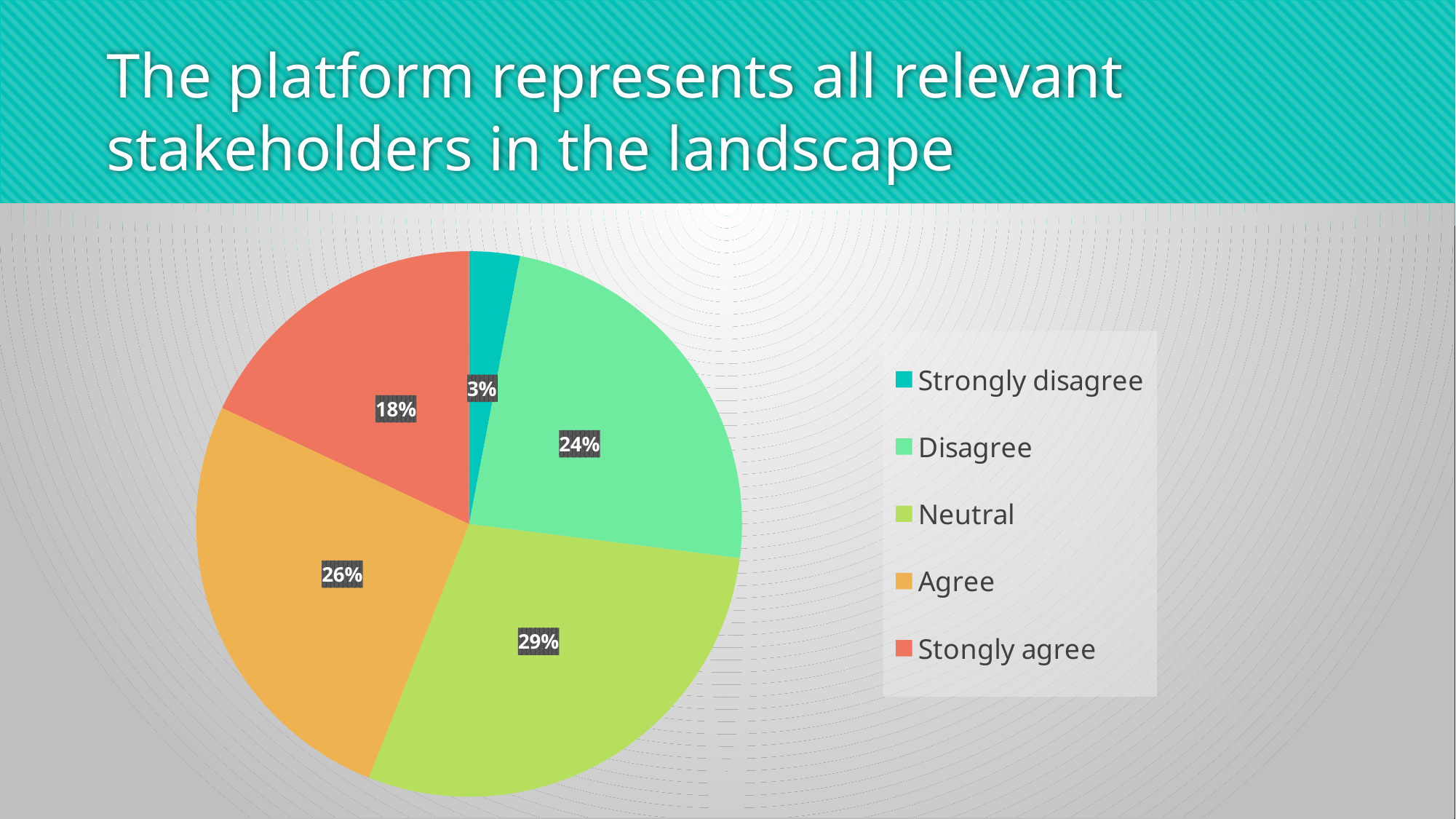
Which response category has the largest share of the pie? Neutral What kind of chart is shown on the slide? pie chart What percentage of respondents chose Strongly disagree? 3% What percentage of respondents chose Disagree? 24% Which is larger, the share for Agree or the share for Disagree? Agree Which response category has the smallest share of the pie? Strongly disagree What is the difference in percentage points between Neutral and Stongly agree? 11 What percentage of respondents chose Stongly agree? 18% What percentage of respondents chose Neutral? 29% What colour is the Neutral slice? green How many categories does the legend list? 5 What percentage of respondents chose Agree? 26%